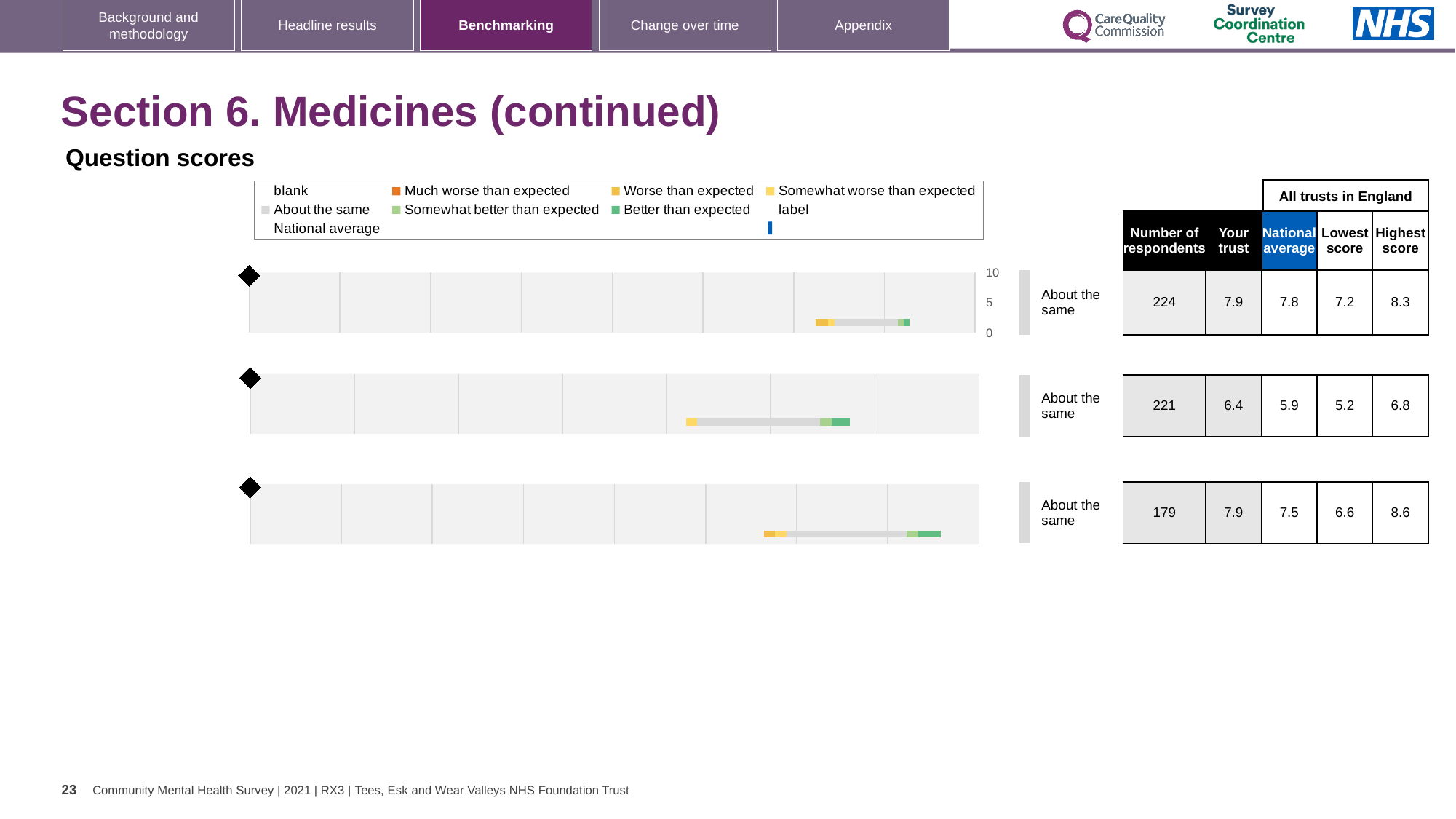
What kind of chart is used for the benchmarking on this slide? Bar chart On the middle chart, what is the lowest score among all trusts in England? 5.2 On the top chart, what is the difference between the 'Your trust' score and the national average? 0.1 On the top chart, what is the national average score? 7.8 How many benchmarking charts are shown on the slide? 3 On the top chart, what is the 'Your trust' score? 7.9 On the middle chart, how many respondents are there? 221 Which of the three charts has the lowest 'Your trust' score? The middle chart What benchmark category label is shown next to the top chart? About the same On the bottom chart, what is the difference between the highest score and the lowest score? 2.0 On the middle chart, which is larger: the 'Your trust' score or the national average? Your trust On the bottom chart, what is the highest score among all trusts in England? 8.6